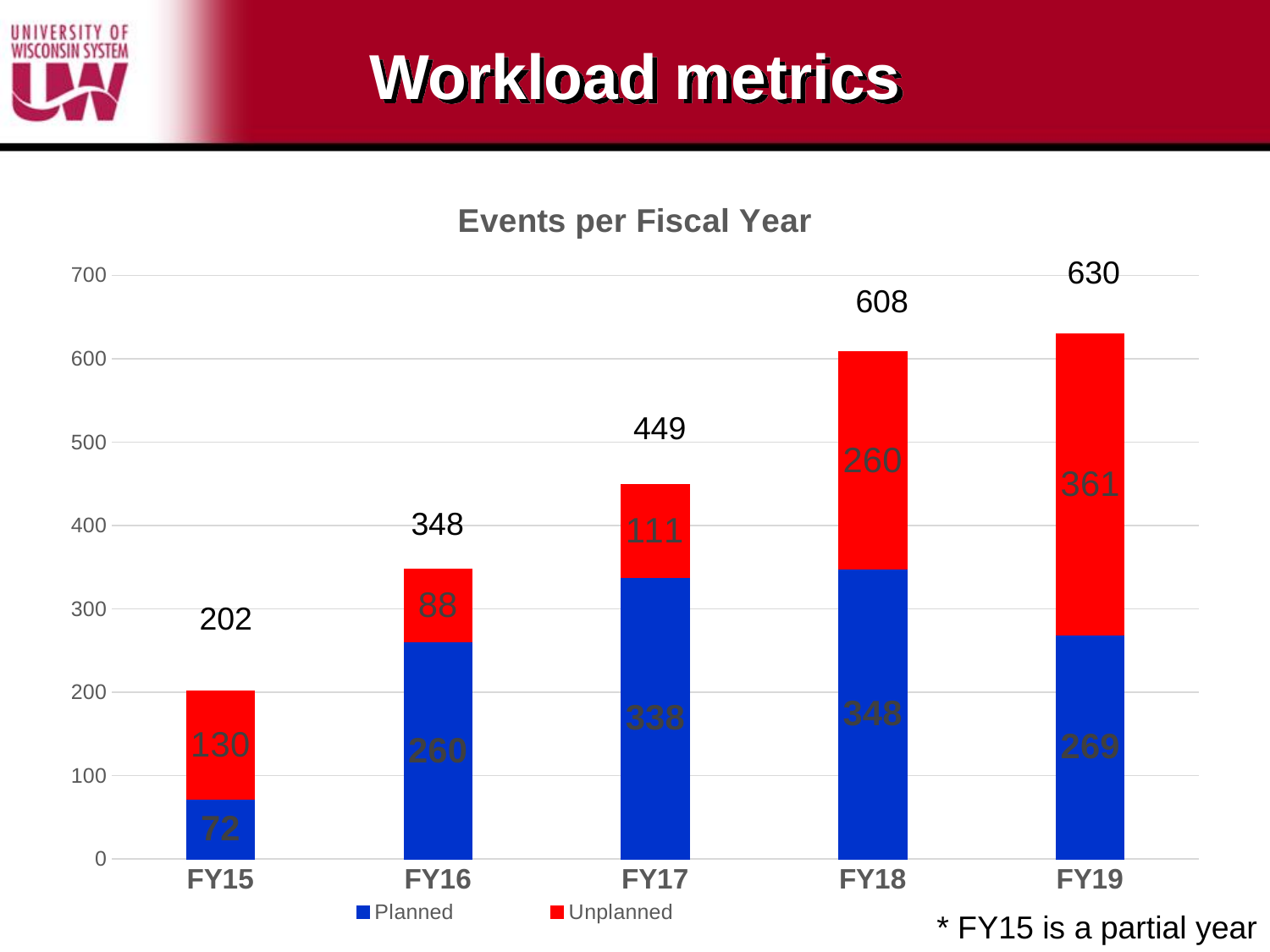
Which is larger, the Planned value for FY16 or the Planned value for FY19? FY19 How many series does the legend list? 2 What is the Unplanned value for FY19? 361 Do the total events rise or fall from FY15 to FY19? Rise Which fiscal year has the lowest Planned value? FY15 How many fiscal years are shown on the x axis? 5 What kind of chart is shown? Stacked bar chart What is the difference between the Unplanned values for FY18 and FY17? 149 Which fiscal year has the highest total events? FY19 What is the Planned value for FY17? 338 What is the title of the chart? Events per Fiscal Year What is the total number of events for FY18? 608